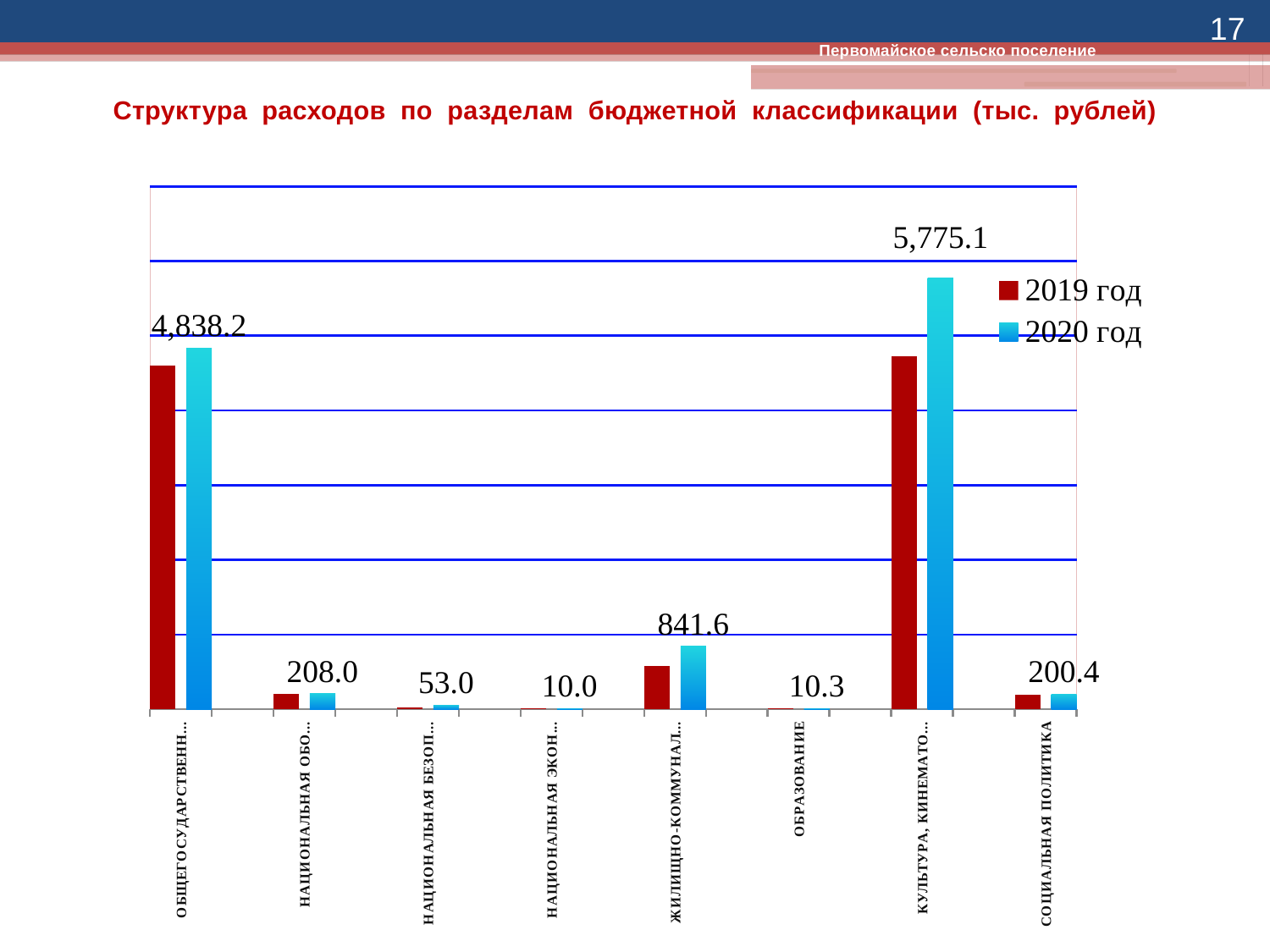
How many series does the legend list? 2 Which category has the highest 2020 год value? КУЛЬТУРА, КИНЕМАТО… (the seventh category) What are the two entries in the chart legend? 2019 год and 2020 год What kind of chart is shown on the slide? bar chart What is the 2020 год value for СОЦИАЛЬНАЯ ПОЛИТИКА? 200.4 For the first category (ОБЩЕГОСУДАРСТВЕНН…), which series has the larger value, 2019 год or 2020 год? 2020 год What is the 2020 год value for ОБРАЗОВАНИЕ? 10.3 What is the 2020 год value for the fifth category (ЖИЛИЩНО-КОММУНАЛ…)? 841.6 Which has the larger 2020 год value, ОБРАЗОВАНИЕ or СОЦИАЛЬНАЯ ПОЛИТИКА? СОЦИАЛЬНАЯ ПОЛИТИКА Which category has the lowest 2020 год value? НАЦИОНАЛЬНАЯ ЭКОН… (the fourth category) What is the difference between the 2020 год values of the seventh category (5,775.1) and the first category (4,838.2)? 936.9 How many categories are shown along the x axis? 8